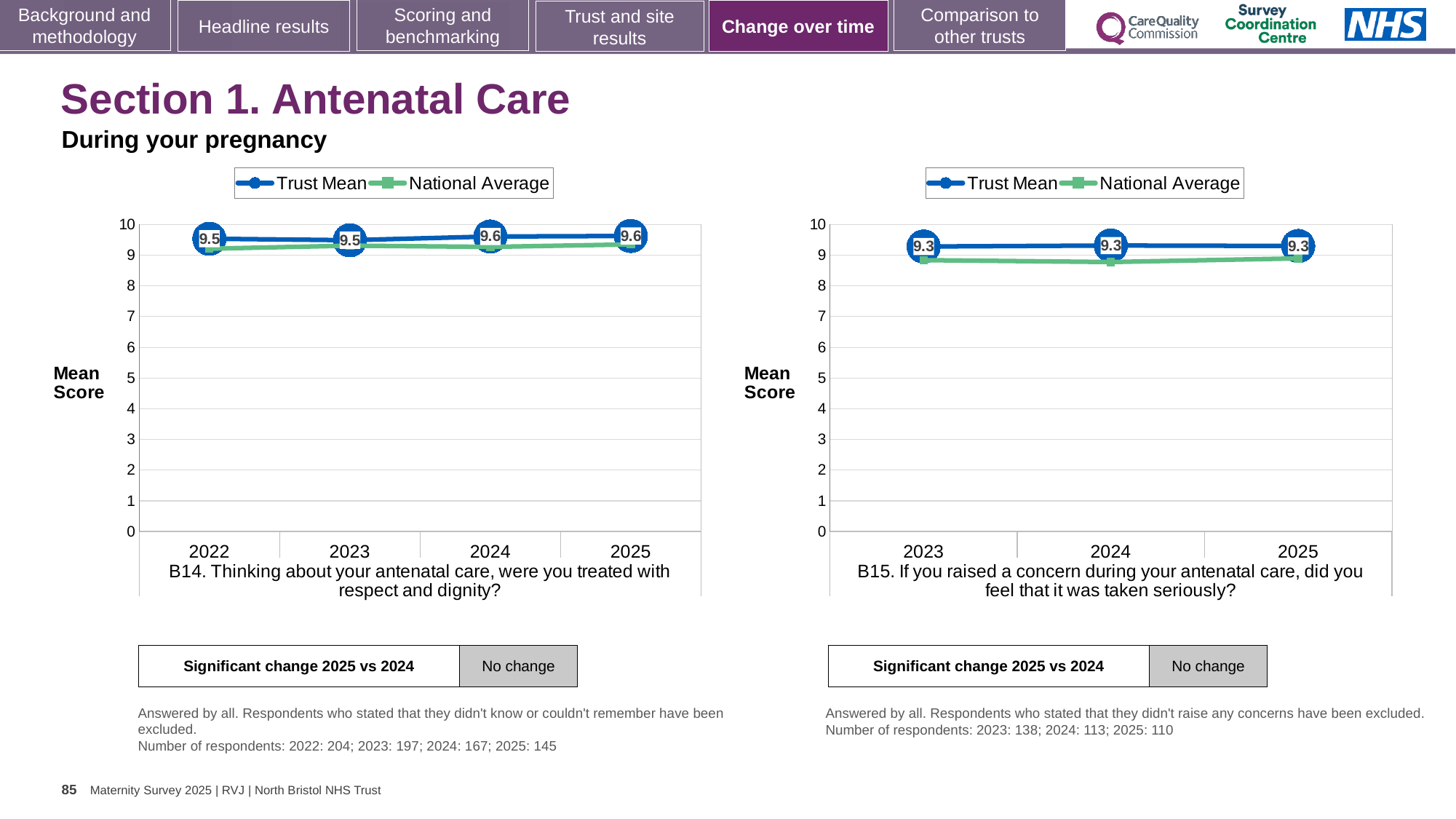
In the B14 chart on the left, what is the difference between the Trust Mean for 2025 and the Trust Mean for 2022? 0.1 In the B15 chart on the right, is the National Average for 2024 greater or less than 8? greater In the B15 chart on the right, how many years are shown on the x axis? 3 What kind of chart is the B14 chart on the left? Line chart In the B14 chart on the left, what label is shown on the y axis? Mean Score In the B14 chart on the left, how many years are shown on the x axis? 4 In the B14 chart on the left, what is the Trust Mean for 2025? 9.6 In the B15 chart on the right, which is larger in 2025, the Trust Mean or the National Average? Trust Mean In the B14 chart on the left, does the Trust Mean rise or fall from 2022 to 2025? Rise In the B14 chart on the left, what is the Trust Mean for 2022? 9.5 In the B15 chart on the right, what is the Trust Mean for 2024? 9.3 In the B15 chart on the right, how many series does the legend list? 2